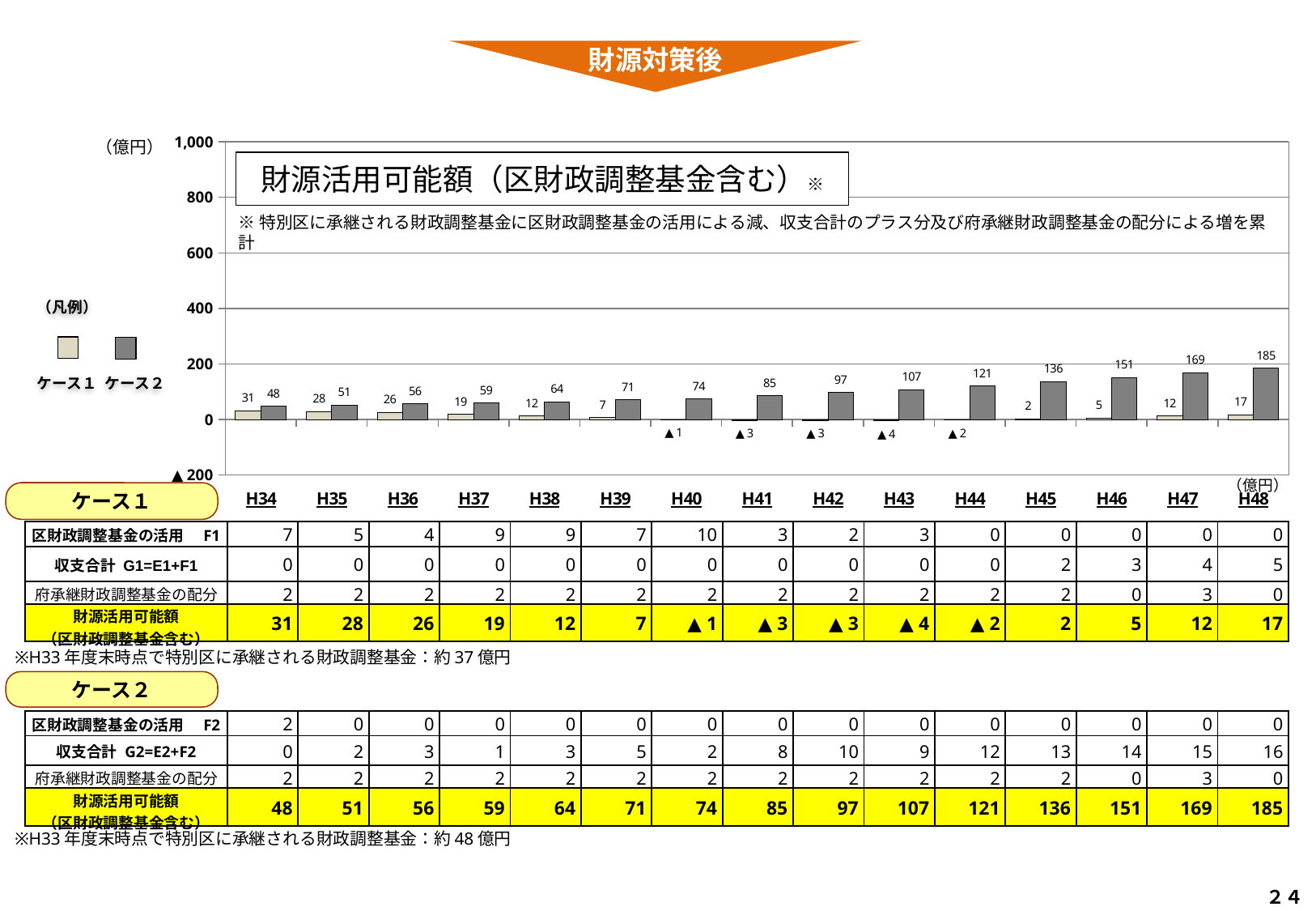
In which year is the value for ケース2 highest? H48 In which year is the value for ケース1 lowest? H43 What is the value for ケース1 in H43? ▲4 What type of chart is shown on the slide? bar chart How many series does the legend list for the chart? 2 What is the value for ケース2 in H48? 185 Which is larger in H39, the value for ケース1 or ケース2? ケース2 What is the title of the chart? 財源活用可能額（区財政調整基金含む） How many fiscal years (categories) are plotted on the x axis of the chart? 15 What is the value for ケース1 in H34? 31 Do the values for ケース2 rise or fall from H34 to H48? rise What is the difference between ケース2 and ケース1 in H48? 168